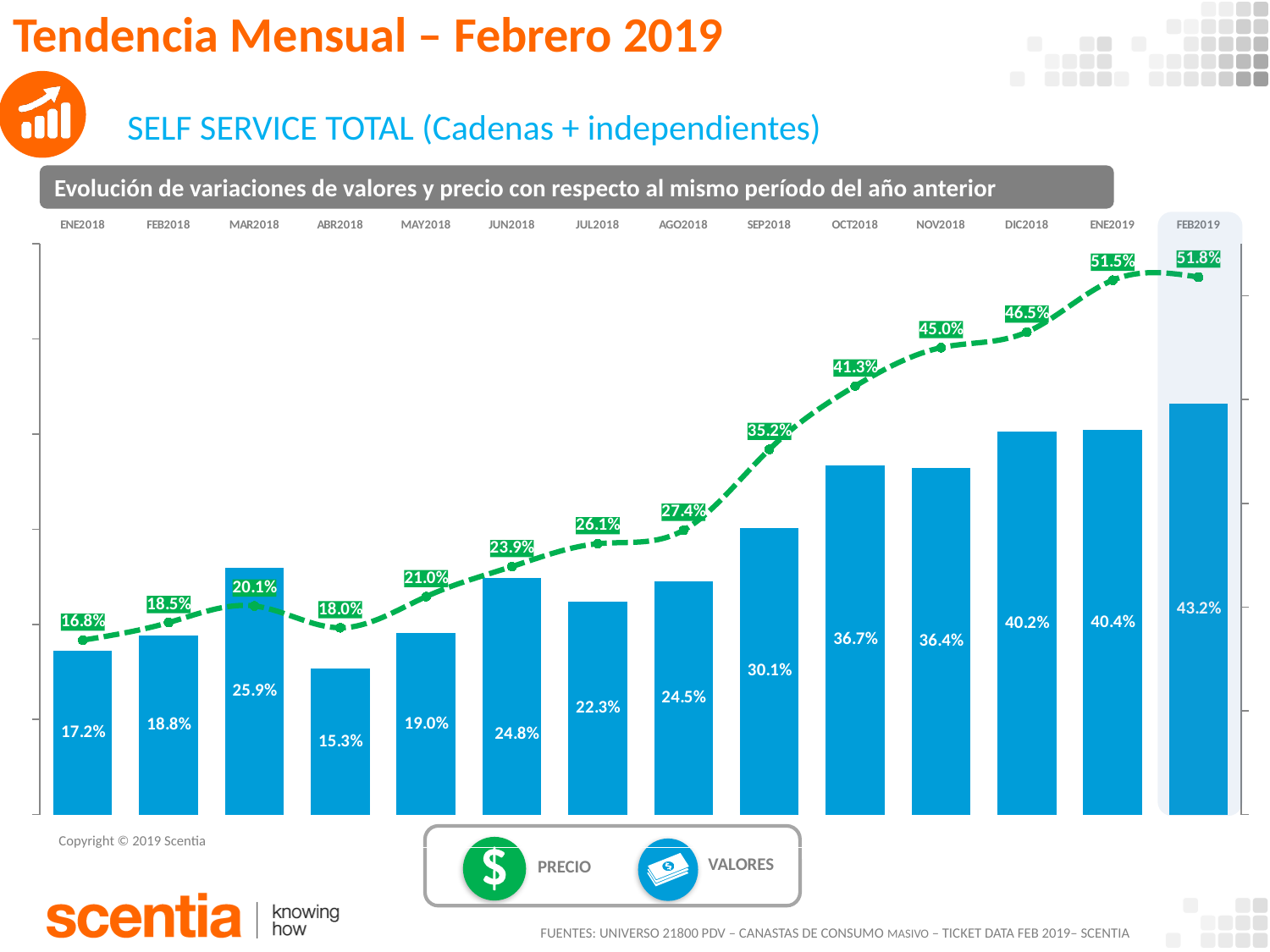
What kind of chart is shown on the slide? Combined bar and line chart What is the VALORES (bar) value for ABR2018? 15.3% Which is larger for MAR2018, the VALORES bar value or the PRECIO line value? VALORES (25.9%) Which month has the lowest PRECIO (dashed line) value? ENE2018 How many series does the legend list? 2 What is the PRECIO (dashed line) value for OCT2018? 41.3% What is the VALORES (bar) value for FEB2019? 43.2% How many months are plotted on the chart? 14 Which month has the lowest VALORES (bar) value? ABR2018 Which month has the highest VALORES (bar) value? FEB2019 Does the PRECIO (dashed line) series generally rise or fall from ENE2018 to FEB2019? Rise What is the difference between the PRECIO value and the VALORES value for FEB2019? 8.6%